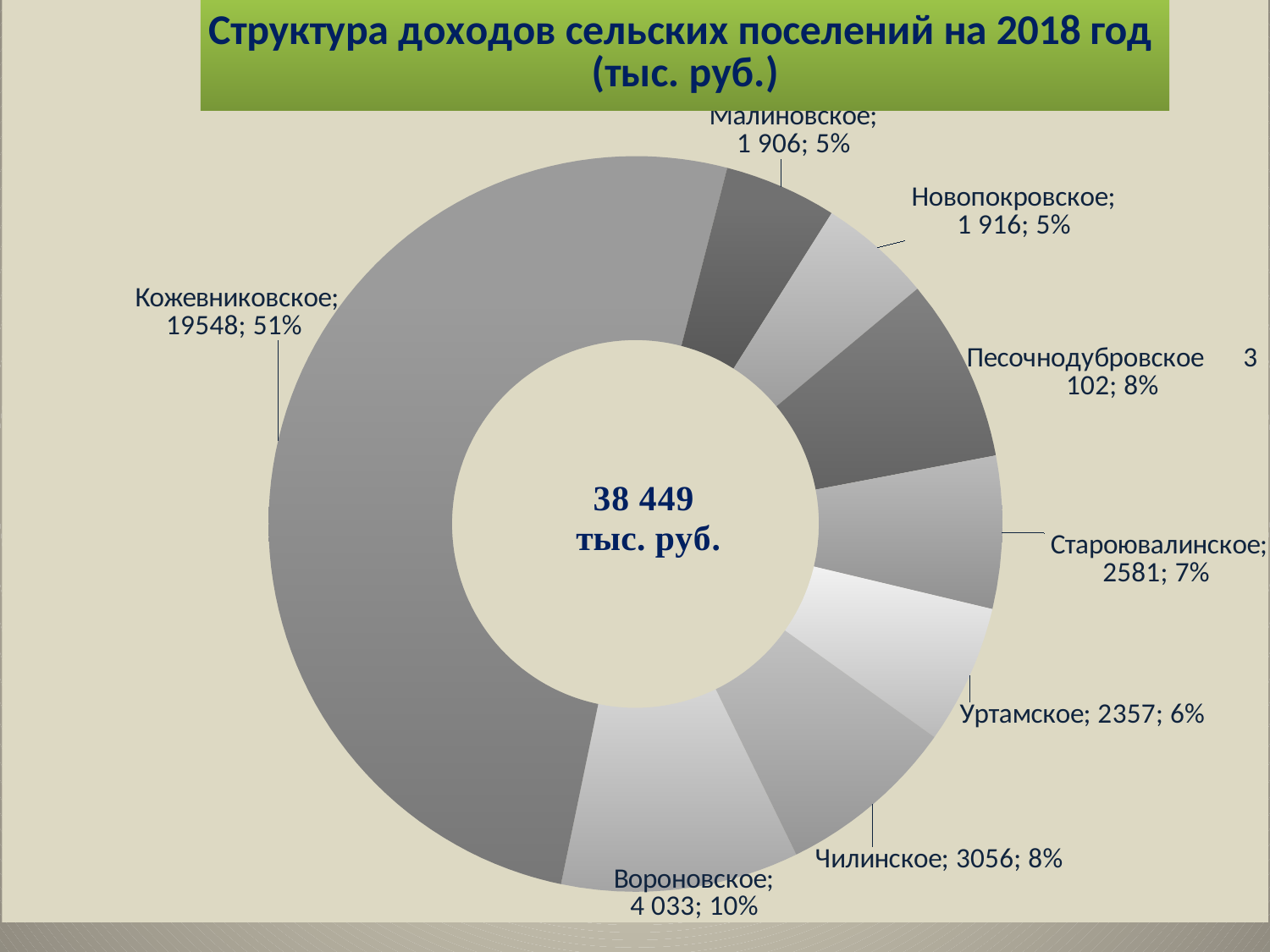
What is the value for Кожевниковское? 19548 What kind of chart is shown on the slide? Doughnut (pie) chart What is the difference between the values for Вороновское and Чилинское? 977 What is the value for Вороновское? 4 033 What total is shown in the centre of the chart? 38 449 тыс. руб. What share of the total does Чилинское account for? 8% Which settlement has the highest income? Кожевниковское Which settlement has the lowest income? Малиновское Which is larger, the value for Староювалинское or Уртамское? Староювалинское What is the title of the chart? Структура доходов сельских поселений на 2018 год (тыс. руб.) How many settlements are shown in the chart? 8 What share of the total does Кожевниковское account for? 51%